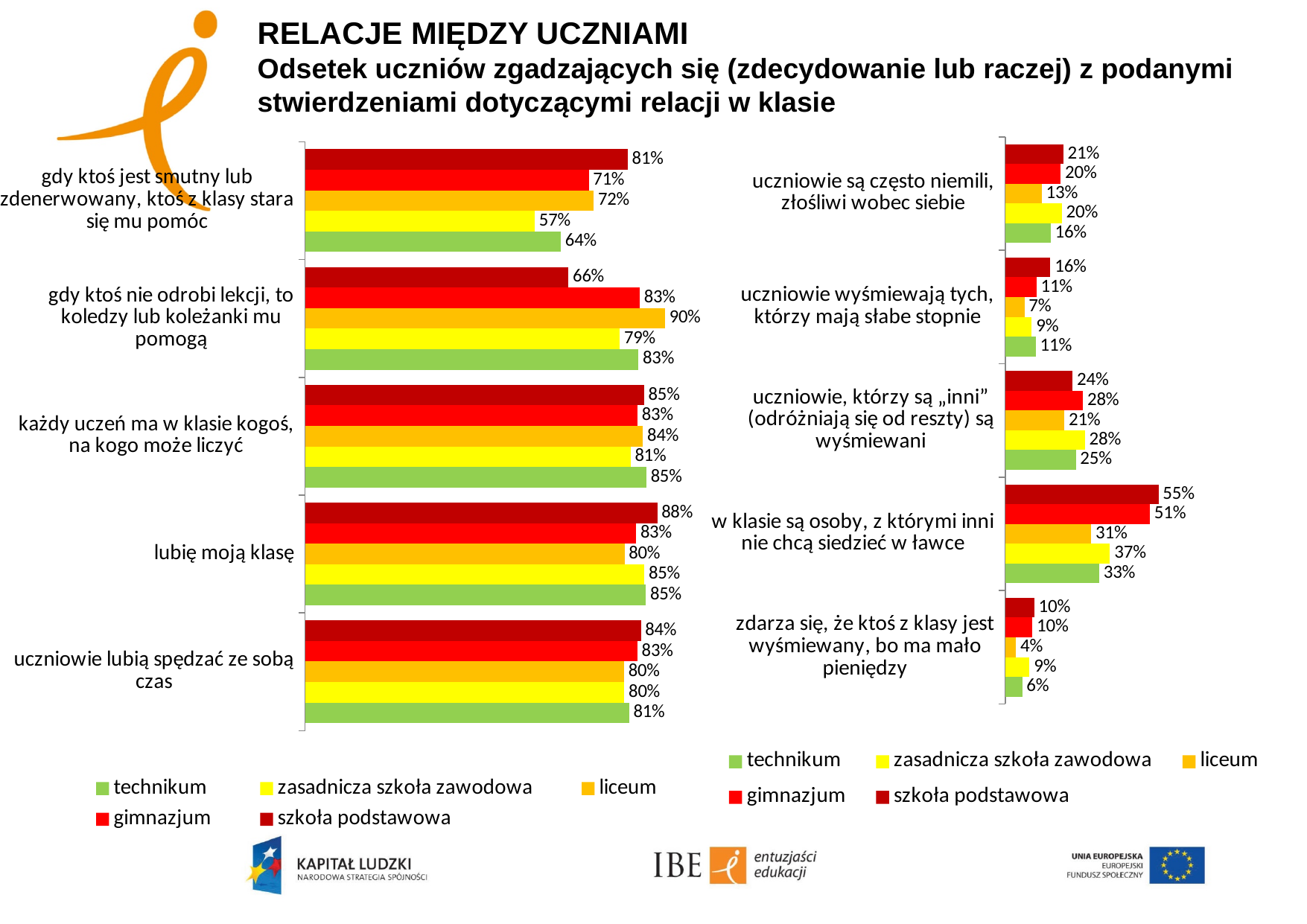
In the left chart, what is the value for zasadnicza szkoła zawodowa for the statement "gdy ktoś jest smutny lub zdenerwowany, ktoś z klasy stara się mu pomóc"? 57% In the left chart, which colour represents technikum? green In the left chart, which school type has the lowest value for "gdy ktoś nie odrobi lekcji, to koledzy lub koleżanki mu pomogą"? szkoła podstawowa In the left chart, what is the value for szkoła podstawowa for the statement "lubię moją klasę"? 88% In the left chart, what is the difference between the liceum and zasadnicza szkoła zawodowa values for "gdy ktoś nie odrobi lekcji, to koledzy lub koleżanki mu pomogą"? 11% How many series does the legend of the right chart list? 5 How many statements (categories) are shown in the left chart? 5 What kind of chart is the right chart? bar chart In the right chart, which is larger for "uczniowie wyśmiewają tych, którzy mają słabe stopnie": the value for szkoła podstawowa or the value for liceum? szkoła podstawowa In the right chart, what is the value for liceum for the statement "zdarza się, że ktoś z klasy jest wyśmiewany, bo ma mało pieniędzy"? 4% In the right chart, which school type has the highest value for "w klasie są osoby, z którymi inni nie chcą siedzieć w ławce"? szkoła podstawowa In the right chart, what is the difference between the szkoła podstawowa and liceum values for "w klasie są osoby, z którymi inni nie chcą siedzieć w ławce"? 24%